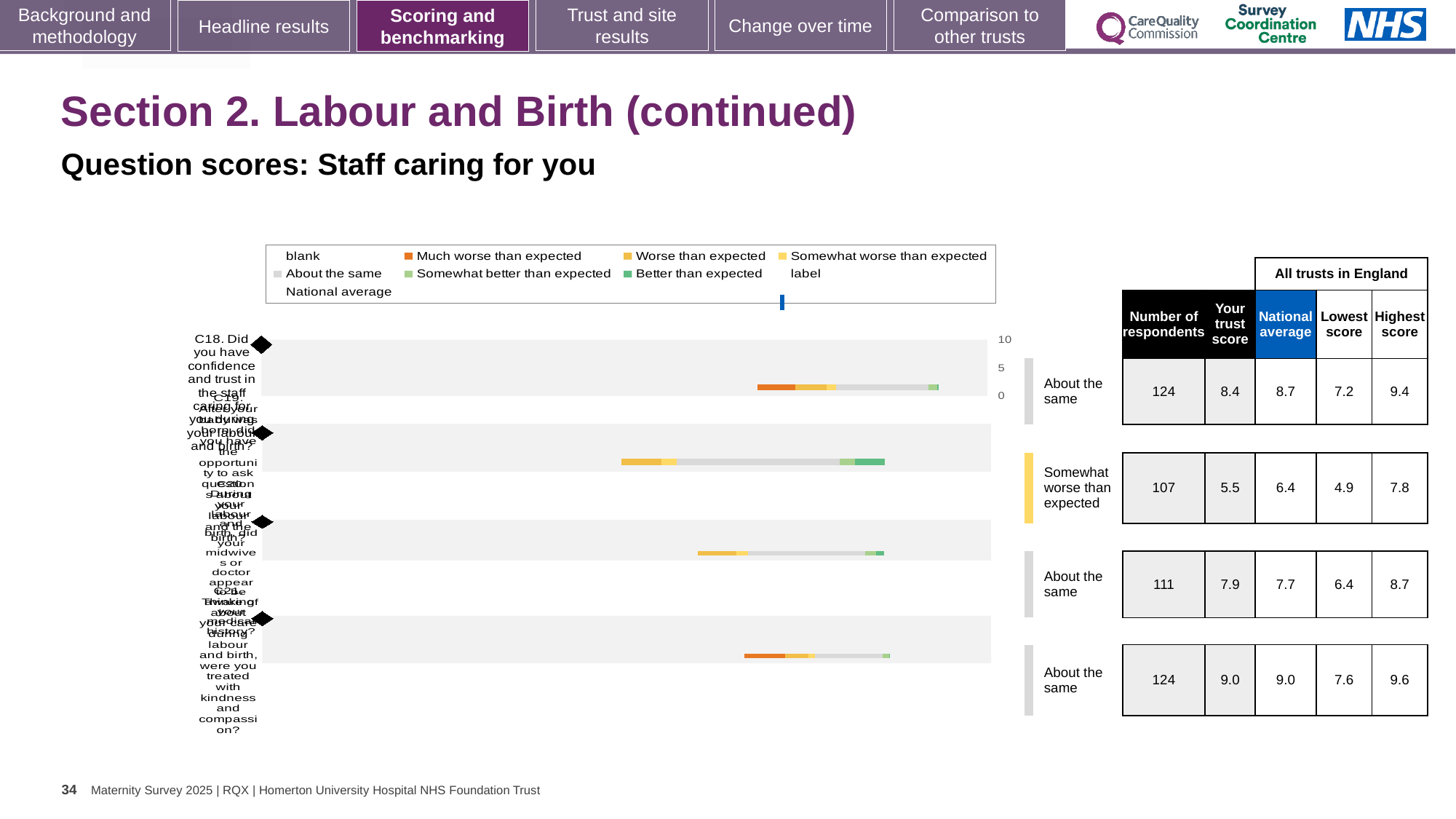
What is the highest score across all trusts in England for the fourth question (C21, treated with kindness and compassion)? 9.6 What is the national average for the second question, rated 'Somewhat worse than expected'? 6.4 How many questions (bars) are plotted in the chart? 4 For the third question, which is larger: the trust score or the national average? the trust score What kind of chart is shown on the slide? bar chart What is the trust score for the second question, rated 'Somewhat worse than expected'? 5.5 What colour does the legend use for 'Somewhat worse than expected'? yellow What is the lowest score across all trusts in England for the second question, rated 'Somewhat worse than expected'? 4.9 How many of the four questions are rated 'About the same'? 3 Which question has the lowest trust score? the second question (rated Somewhat worse than expected) What is the difference between the national average and the trust score for the second question, rated 'Somewhat worse than expected'? 0.9 What is the number of respondents for question C18 (confidence and trust in the staff caring for you)? 124